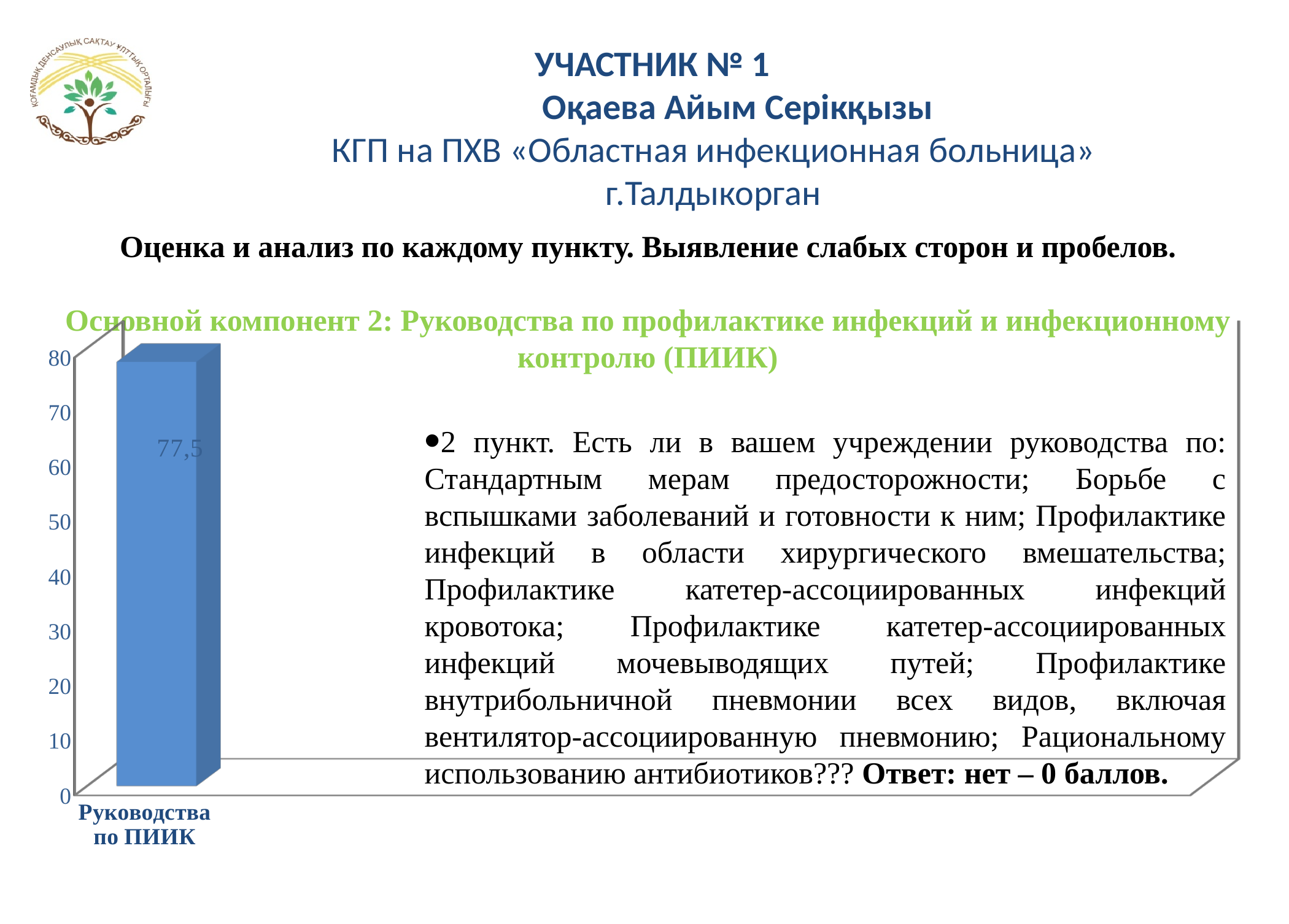
Is the value for "Руководства по ПИИК" greater or less than 80? less What is the highest tick value shown on the vertical axis of the chart? 80 Is the value for "Руководства по ПИИК" greater or less than 70? greater What is the category label shown under the bar in the chart? Руководства по ПИИК What kind of chart is shown on the slide? Bar chart What is the value shown for the bar labelled "Руководства по ПИИК"? 77,5 How many bars are plotted in the chart? 1